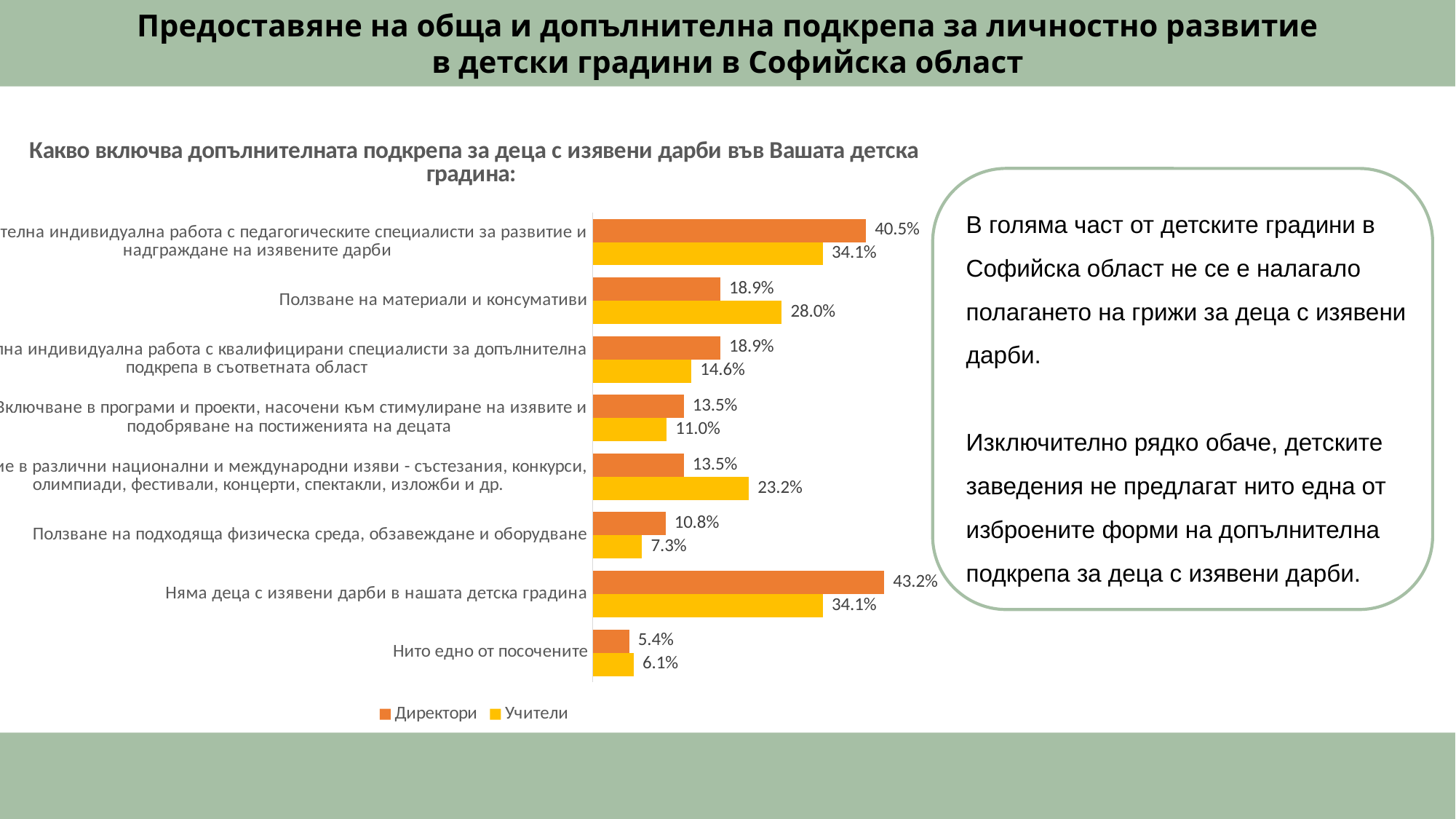
What is the value for Директори for the category 'Ползване на материали и консумативи'? 18.9% How many series does the chart legend list? 2 How many categories are plotted in the chart? 8 What is the value for Учители for the category 'Ползване на материали и консумативи'? 28.0% Which category has the highest value for Директори? Няма деца с изявени дарби в нашата детска градина For the category 'Ползване на материали и консумативи', which series has the larger value, Директори or Учители? Учители What type of chart is shown on the slide? bar chart What is the difference between the Директори and Учители values for 'Ползване на подходяща физическа среда, обзавеждане и оборудване'? 3.5% Which colour represents the Учители series in the chart? yellow What is the value for Учители for the category 'Нито едно от посочените'? 6.1% What is the value for Директори for the category 'Няма деца с изявени дарби в нашата детска градина'? 43.2% Which category has the lowest value for Учители? Нито едно от посочените